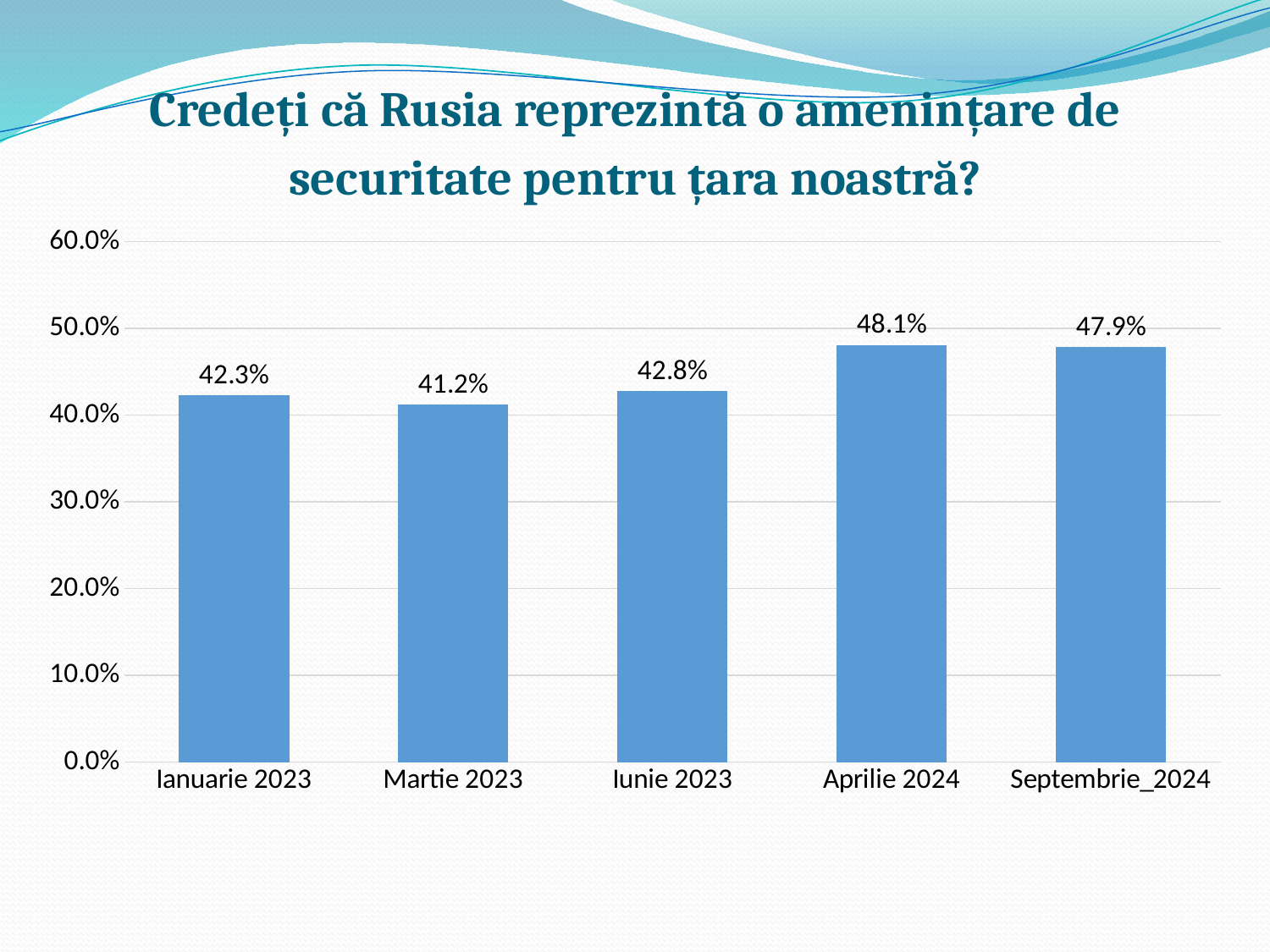
Is the value for Aprilie 2024 greater or less than 40.0%? greater Which is larger, the value for Iunie 2023 or the value for Ianuarie 2023? Iunie 2023 How many categories are shown on the x axis? 5 What is the value for Ianuarie 2023? 42.3% What is the difference between the values for Aprilie 2024 and Martie 2023? 6.9% What kind of chart is shown on the slide? bar chart What is the value for Aprilie 2024? 48.1% What is the value for Septembrie_2024? 47.9% What is the value for Martie 2023? 41.2% What is the title of the chart? Credeți că Rusia reprezintă o amenințare de securitate pentru țara noastră? Which category has the lowest value? Martie 2023 Which category has the highest value? Aprilie 2024